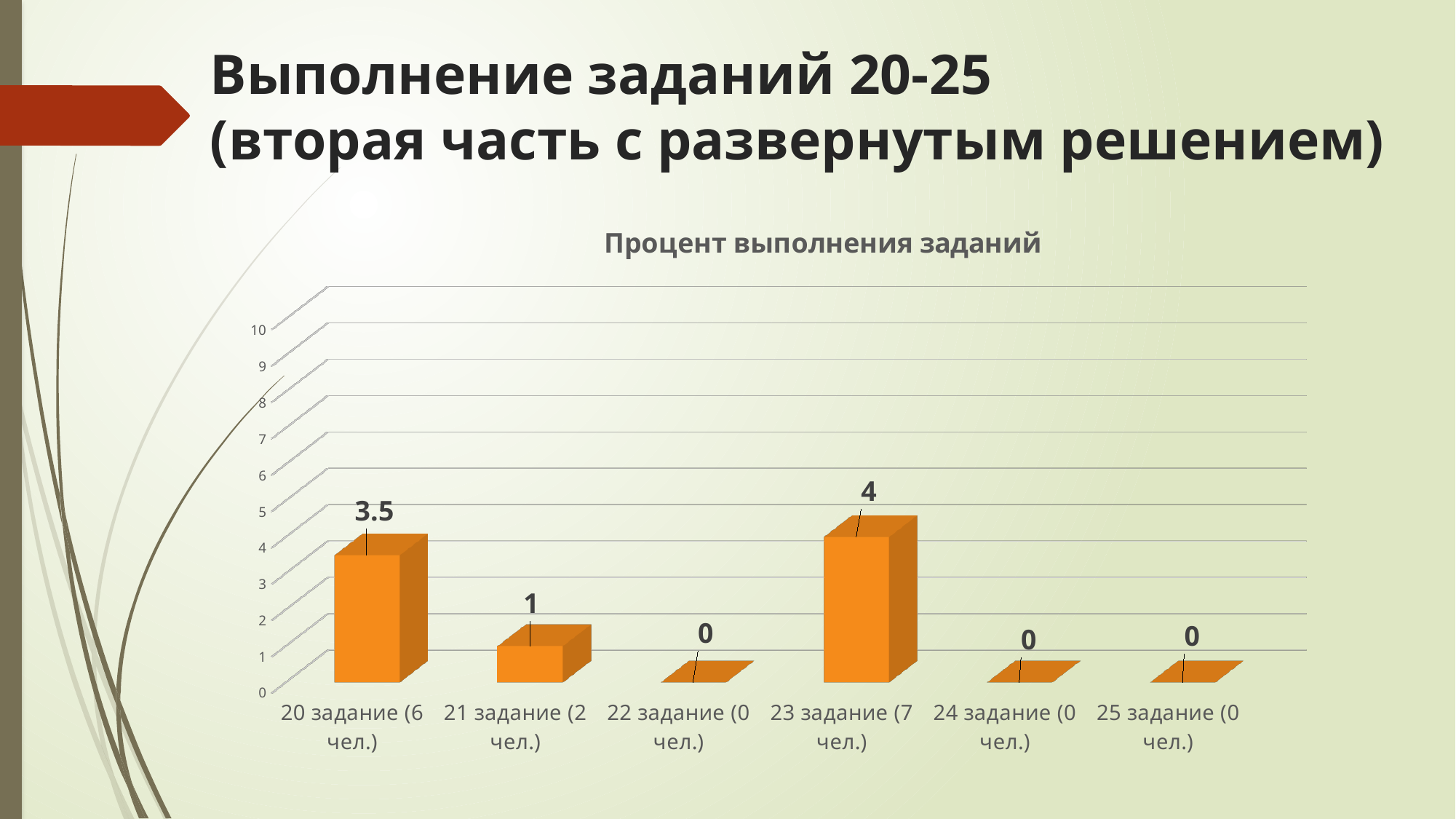
How many categories are shown on the x axis? 6 Which category has the highest value? 23 задание (7 чел.) What kind of chart is shown on the slide? bar chart What is the title of the chart? Процент выполнения заданий What is the difference between the values for "23 задание (7 чел.)" and "20 задание (6 чел.)"? 0.5 What is the value for "24 задание (0 чел.)"? 0 What is the value for "23 задание (7 чел.)"? 4 What is the difference between the values for "20 задание (6 чел.)" and "21 задание (2 чел.)"? 2.5 Which is larger, the value for "20 задание (6 чел.)" or the value for "21 задание (2 чел.)"? 20 задание (6 чел.) What is the value for "20 задание (6 чел.)"? 3.5 What is the value for "21 задание (2 чел.)"? 1 Is the value for "23 задание (7 чел.)" greater or less than 5? less